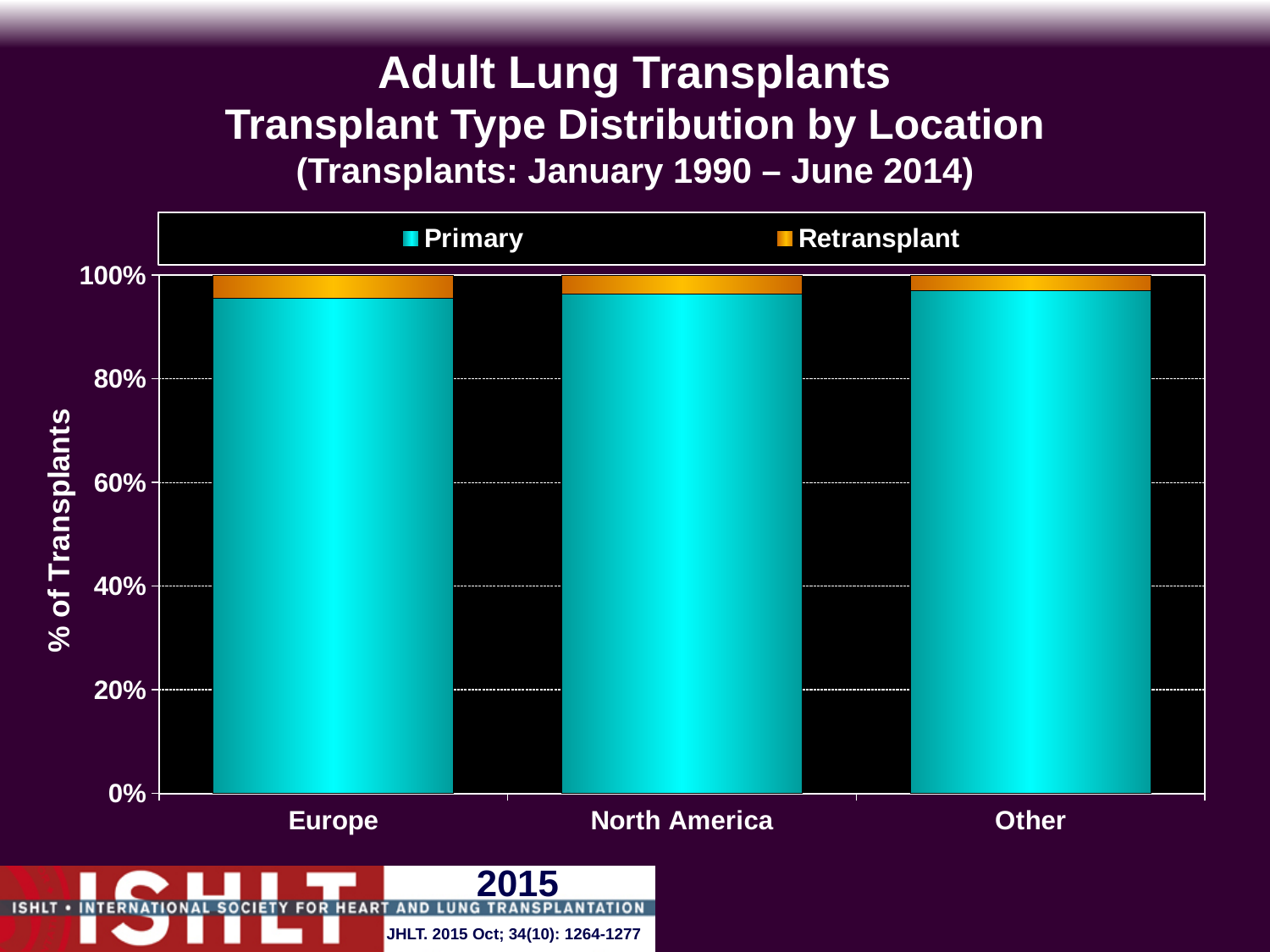
What is the total height of the stacked bar for North America? 100% How many series does the legend list? 2 What kind of chart is shown on the slide? Stacked bar chart Is the Primary value for Europe greater or less than 80%? greater Is the Retransplant value for Europe greater or less than 20%? less How many location categories are shown on the x axis? 3 Is the Primary value for Other greater or less than 60%? greater Which category is listed first on the x axis? Europe For Europe, which series is larger, Primary or Retransplant? Primary What is the label of the y axis? % of Transplants What are the two series named in the legend? Primary and Retransplant